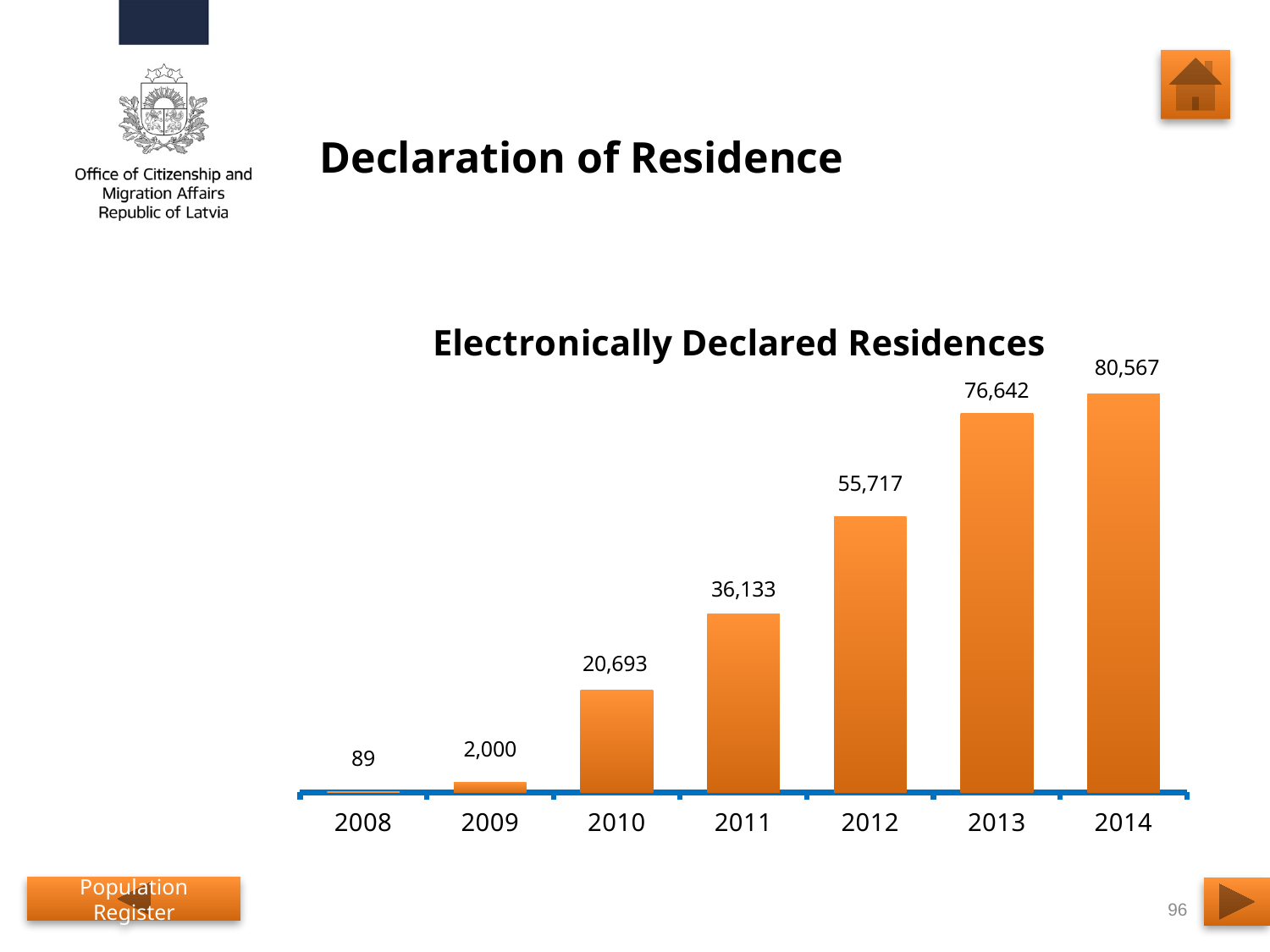
Which is larger in the Electronically Declared Residences chart, the value for 2011 or the value for 2012? 2012 What is the difference between the values for 2014 and 2013 in the Electronically Declared Residences chart? 3,925 Do the values in the Electronically Declared Residences chart rise or fall from 2008 to 2014? rise What is the value for 2012 in the Electronically Declared Residences chart? 55,717 What is the value for 2014 in the Electronically Declared Residences chart? 80,567 Which year has the highest value in the Electronically Declared Residences chart? 2014 How many years are shown on the x axis of the Electronically Declared Residences chart? 7 What is the difference between the values for 2011 and 2010 in the Electronically Declared Residences chart? 15,440 What kind of chart is the Electronically Declared Residences chart? bar chart What is the title of the chart on the slide? Electronically Declared Residences What is the value for 2009 in the Electronically Declared Residences chart? 2,000 Which year has the lowest value in the Electronically Declared Residences chart? 2008